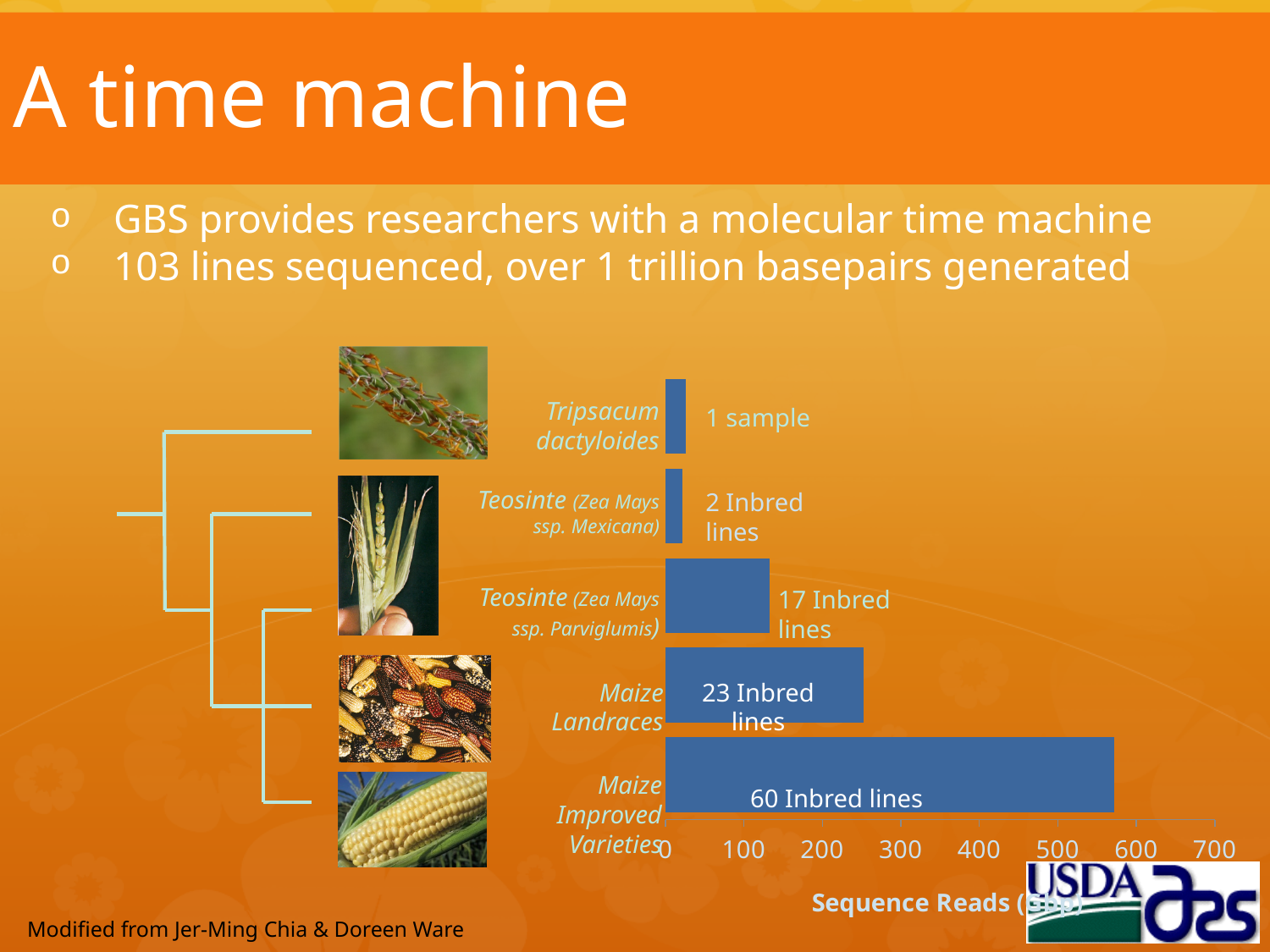
What label is printed on the bar for Maize Improved Varieties? 60 Inbred lines Which has more sequence reads, Maize Improved Varieties or Maize Landraces? Maize Improved Varieties Is the value for Tripsacum dactyloides greater or less than 100? less How many categories (bars) does the chart show? 5 Which category has the highest number of sequence reads? Maize Improved Varieties What is the title of the x axis of the chart? Sequence Reads (Gbp) What kind of chart is shown on the slide? bar chart Which has more sequence reads, Maize Landraces or Teosinte (Zea Mays ssp. Parviglumis)? Maize Landraces Is the value for Maize Improved Varieties greater or less than 500? greater Is the value for Maize Landraces greater or less than 300? less